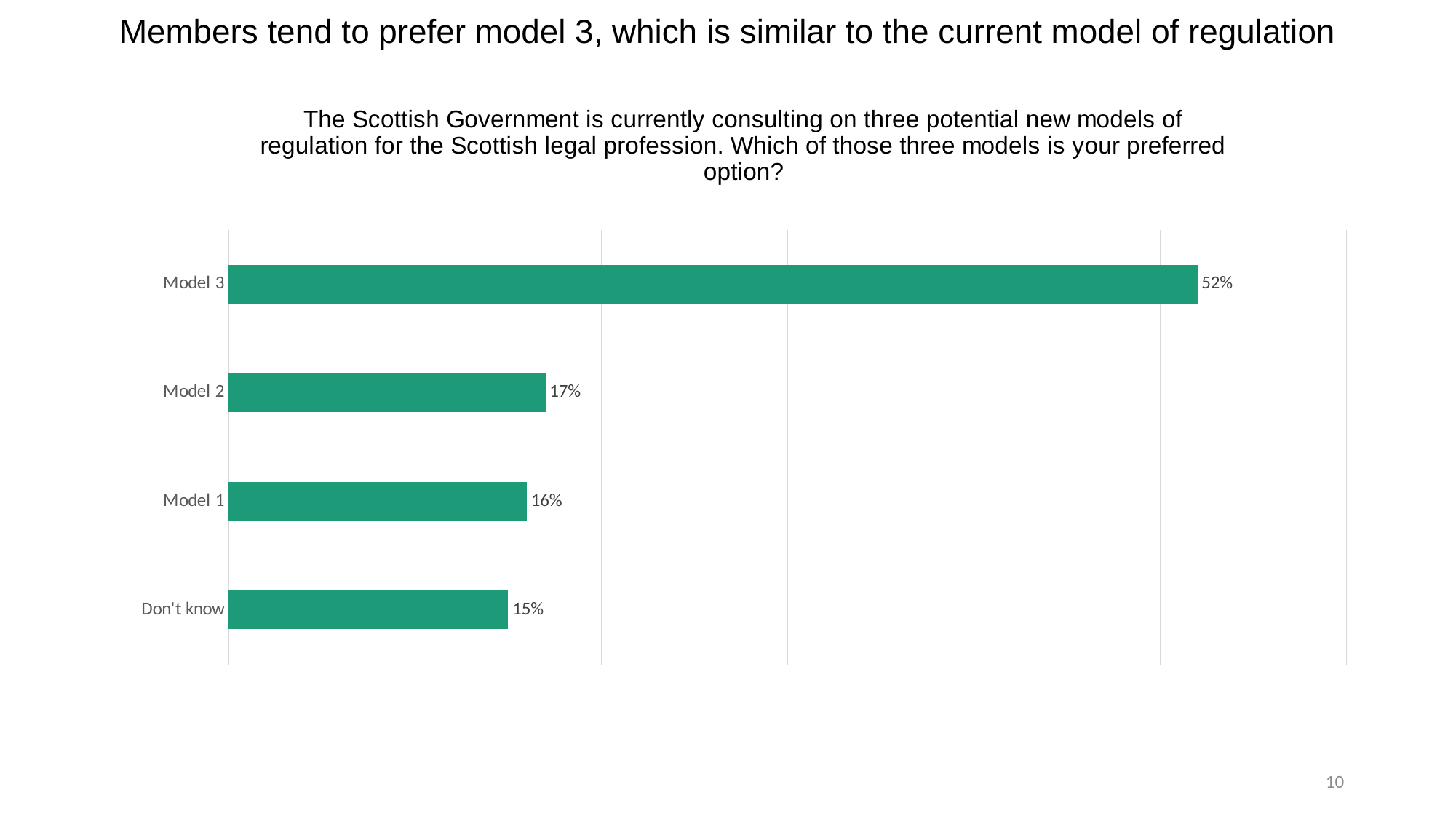
What colour are the bars in the chart? Green What kind of chart is shown on the slide? Bar chart What percentage of members preferred Model 1? 16% What percentage of members preferred Model 3? 52% What percentage of members answered Don't know? 15% Which option has the highest percentage? Model 3 What is the difference in percentage points between Model 1 and Don't know? 1 What is the difference in percentage points between Model 3 and Model 2? 35 How many categories are shown in the chart? 4 Which is larger, the value for Model 3 or the value for Model 1? Model 3 What percentage of members preferred Model 2? 17% Which option has the lowest percentage? Don't know